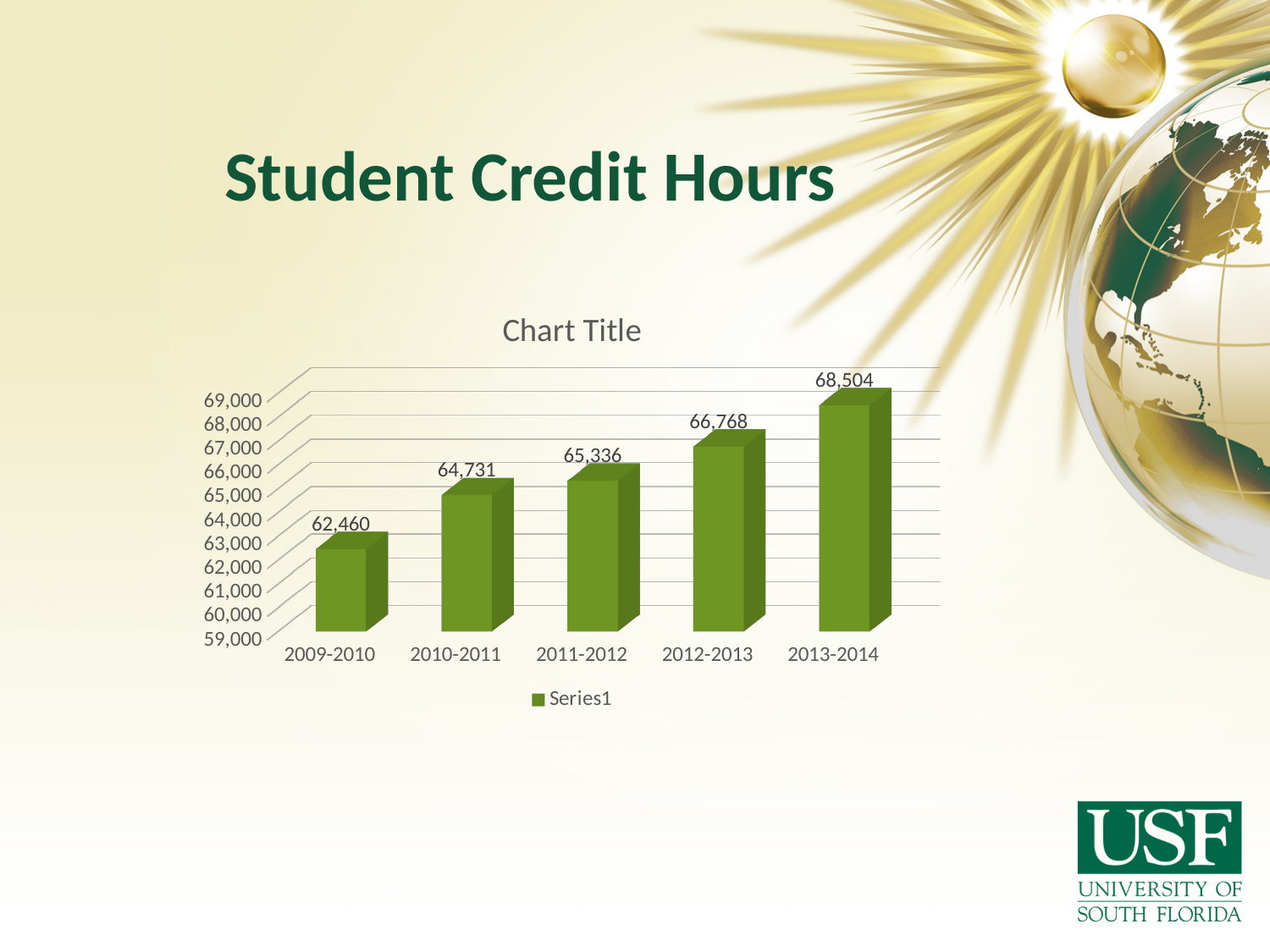
What is the value for 2009-2010? 62,460 Which year has the highest value? 2013-2014 Which is larger, the value for 2010-2011 or the value for 2012-2013? 2012-2013 What is the difference between the values for 2012-2013 and 2011-2012? 1,432 How many years are shown on the x axis? 5 What is the difference between the values for 2013-2014 and 2009-2010? 6,044 Do the values rise or fall from 2009-2010 to 2013-2014? rise What kind of chart is shown? bar chart What is the value for 2013-2014? 68,504 Is the value for 2010-2011 greater or less than 64,000? greater Which year has the lowest value? 2009-2010 What is the value for 2011-2012? 65,336